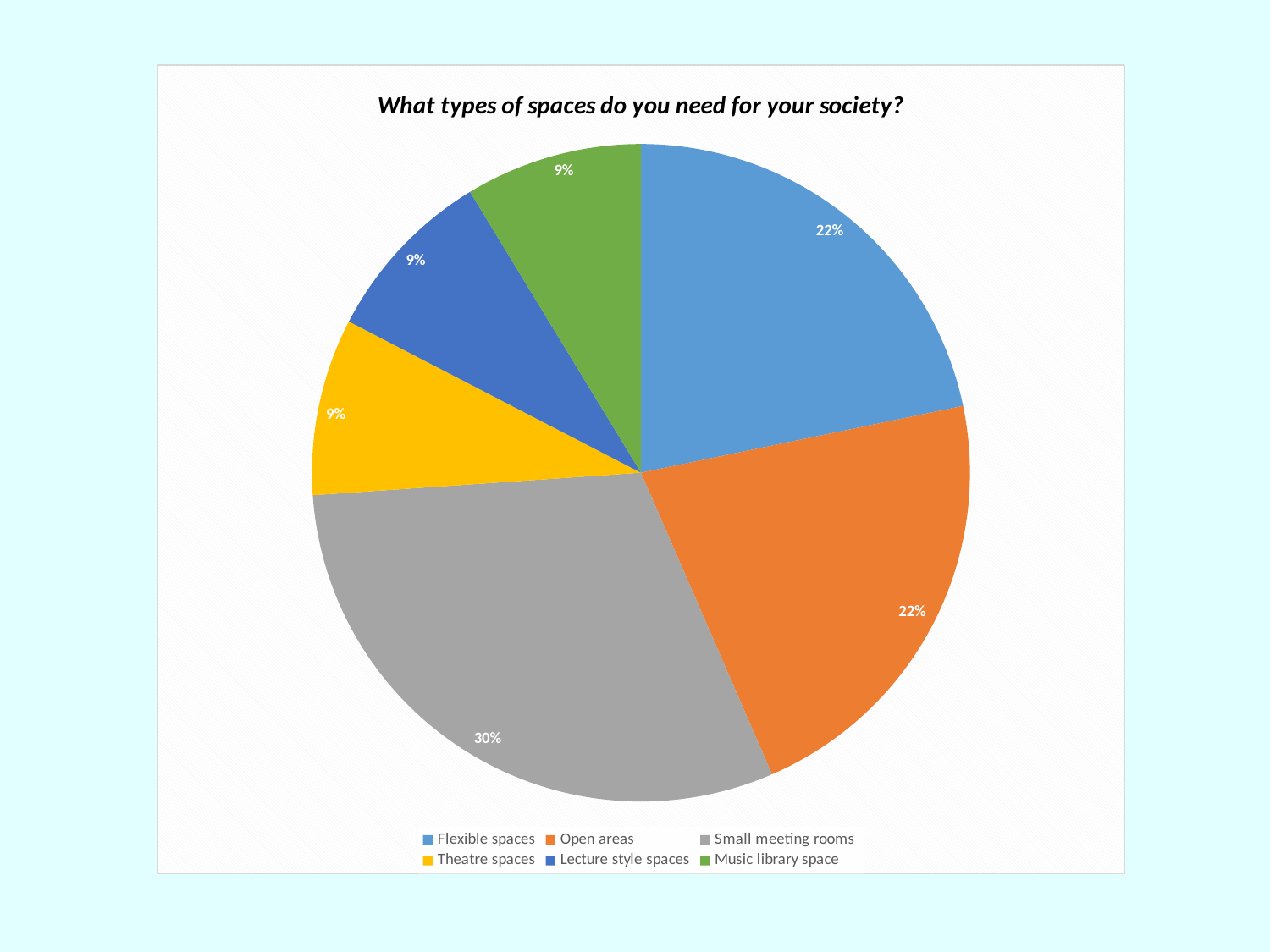
How many categories does the legend list? 6 Which category has the largest slice of the pie? Small meeting rooms What is the title of the chart? What types of spaces do you need for your society? What share of the pie is Music library space? 9% Which is larger, the share for Open areas or the share for Theatre spaces? Open areas What colour is the Small meeting rooms slice? Grey What is the difference between the share for Small meeting rooms and the share for Lecture style spaces? 21% What share of the pie is Flexible spaces? 22% What share of the pie is Small meeting rooms? 30% What type of chart is shown on the slide? Pie chart